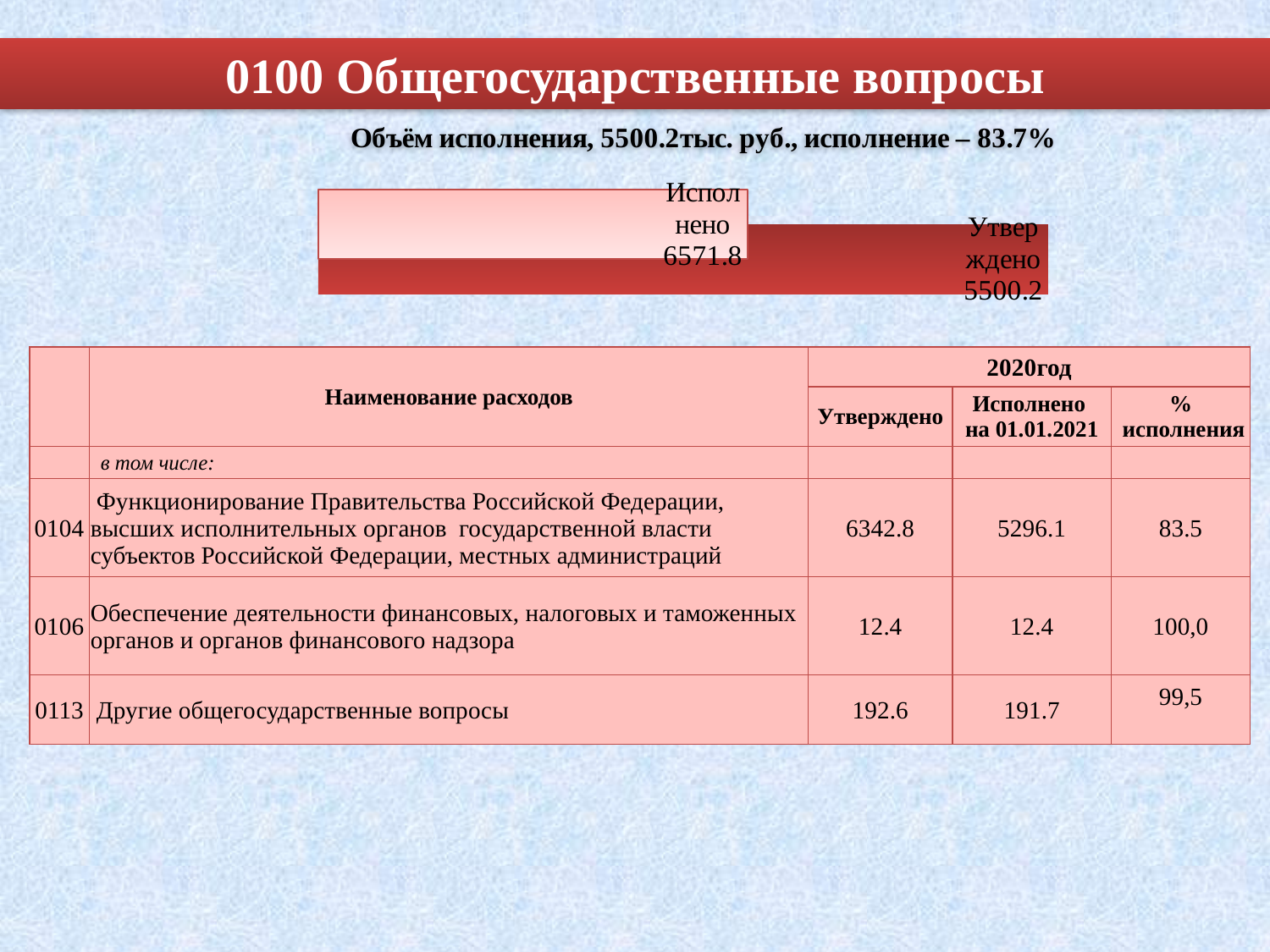
What colour is the bar labelled "Утверждено" in the chart? Dark red What value is printed on the bar labelled "Исполнено"? 6571.8 What is the difference between the values labelled "Исполнено" and "Утверждено" in the chart? 1071.6 What kind of chart is shown on the slide? Bar chart What value is printed on the bar labelled "Утверждено"? 5500.2 Are the bars in the chart drawn horizontally or vertically? Horizontally How many bars does the chart contain? 2